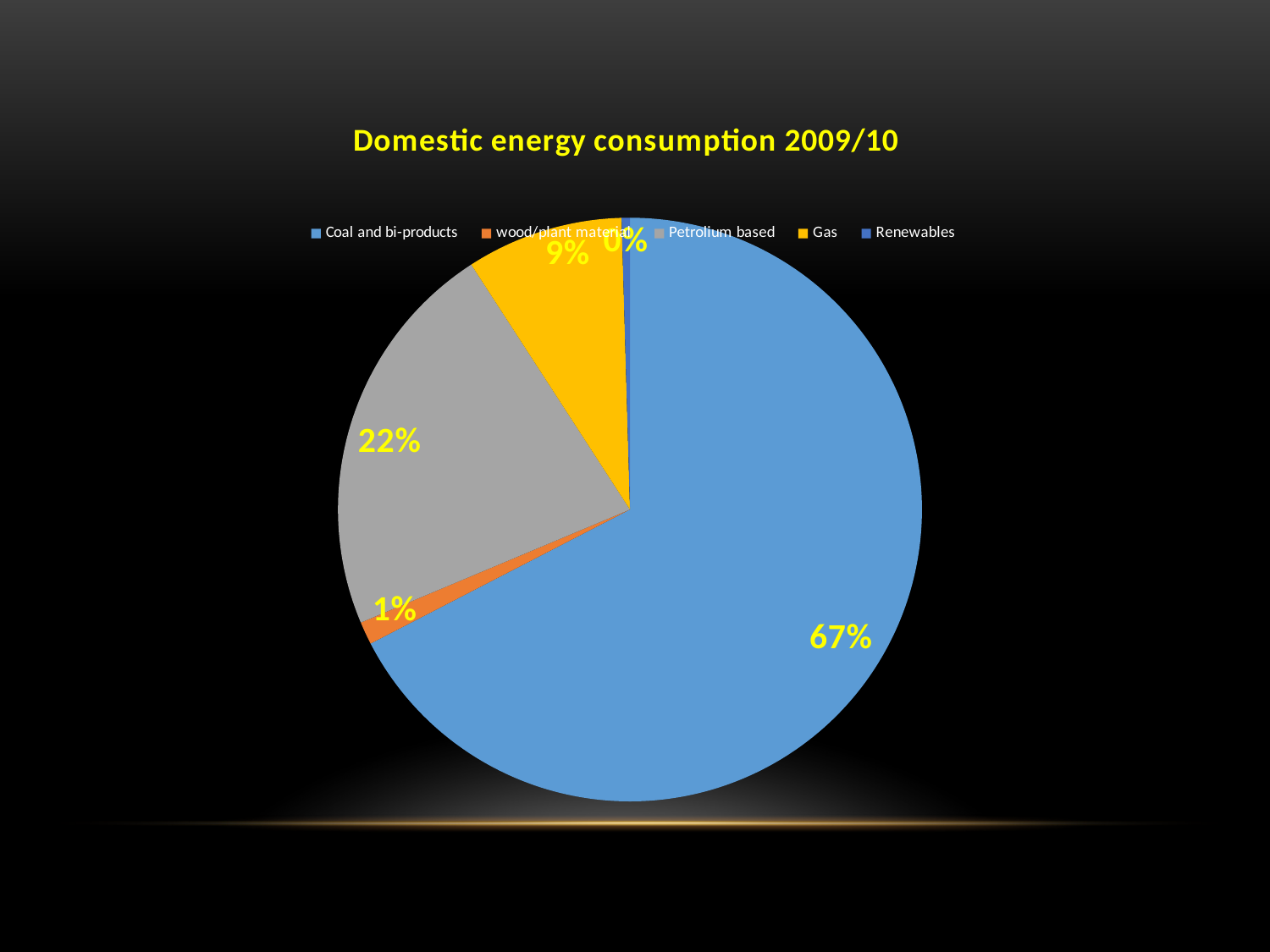
What is the difference in percentage points between Coal and bi-products and Petrolium based? 45 What share of domestic energy consumption is Petrolium based? 22% What share of domestic energy consumption is Coal and bi-products? 67% Which category has the smallest share of the pie? Renewables What share of domestic energy consumption is Gas? 9% What type of chart is shown on the slide? pie chart Which is larger, the share for Gas or the share for Petrolium based? Petrolium based What is the title of the chart? Domestic energy consumption 2009/10 What share of domestic energy consumption is Renewables? 0% How many categories does the legend list? 5 What share of domestic energy consumption is wood/plant material? 1% Which category has the largest share of the pie? Coal and bi-products